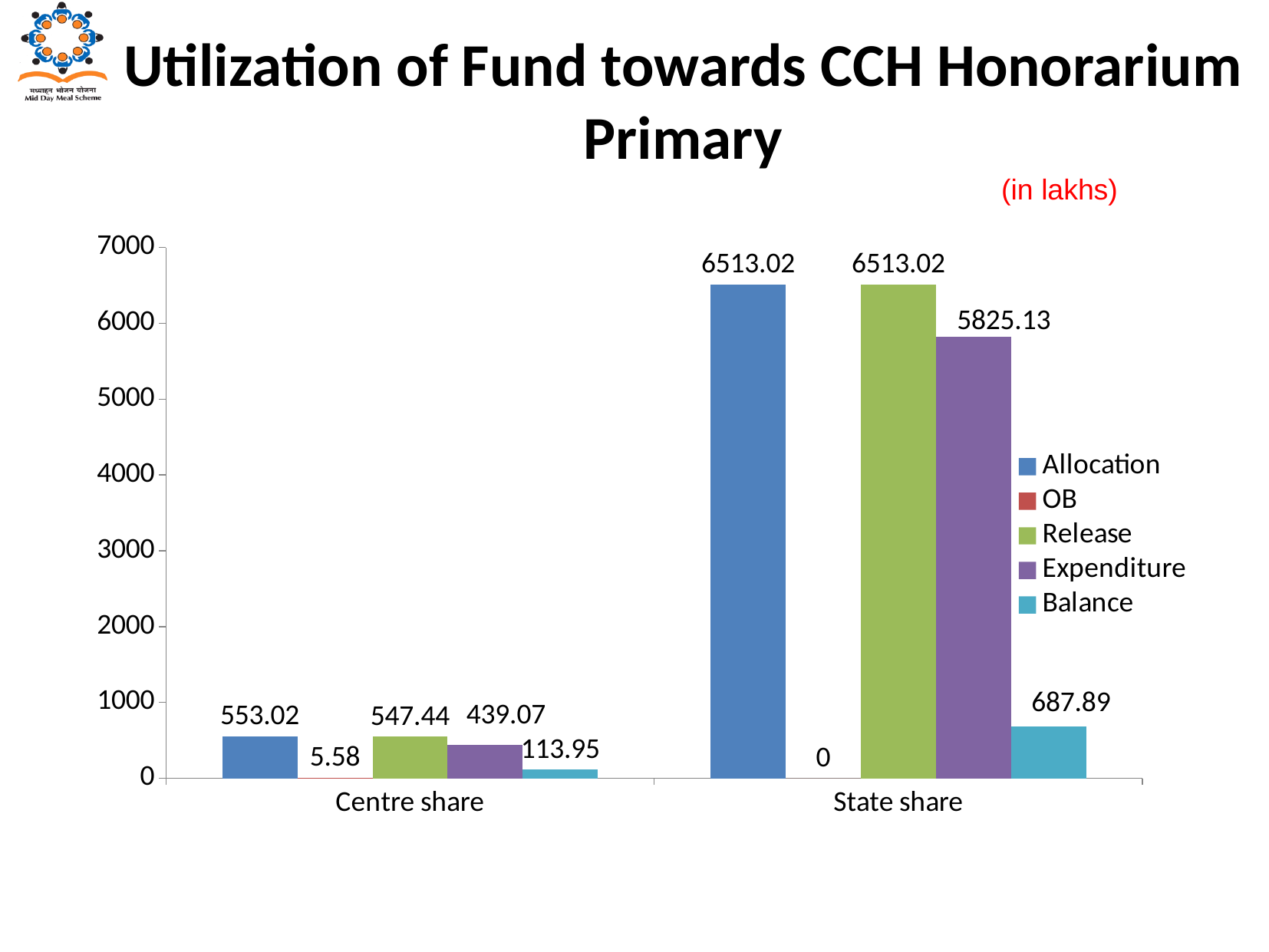
What is the difference between Release and Expenditure for State share? 687.89 What is the Balance value for State share? 687.89 How many categories are shown on the x axis? 2 How many series does the legend list? 5 What is the OB value for Centre share? 5.58 What kind of chart is shown on the slide? Bar chart What unit is stated for the values in the chart? in lakhs What is the Allocation value for Centre share? 553.02 Which is larger: the Expenditure for Centre share or the Balance for Centre share? Expenditure for Centre share What is the Expenditure value for State share? 5825.13 Which series has the highest value for Centre share? Allocation Which series has the lowest value for State share? OB